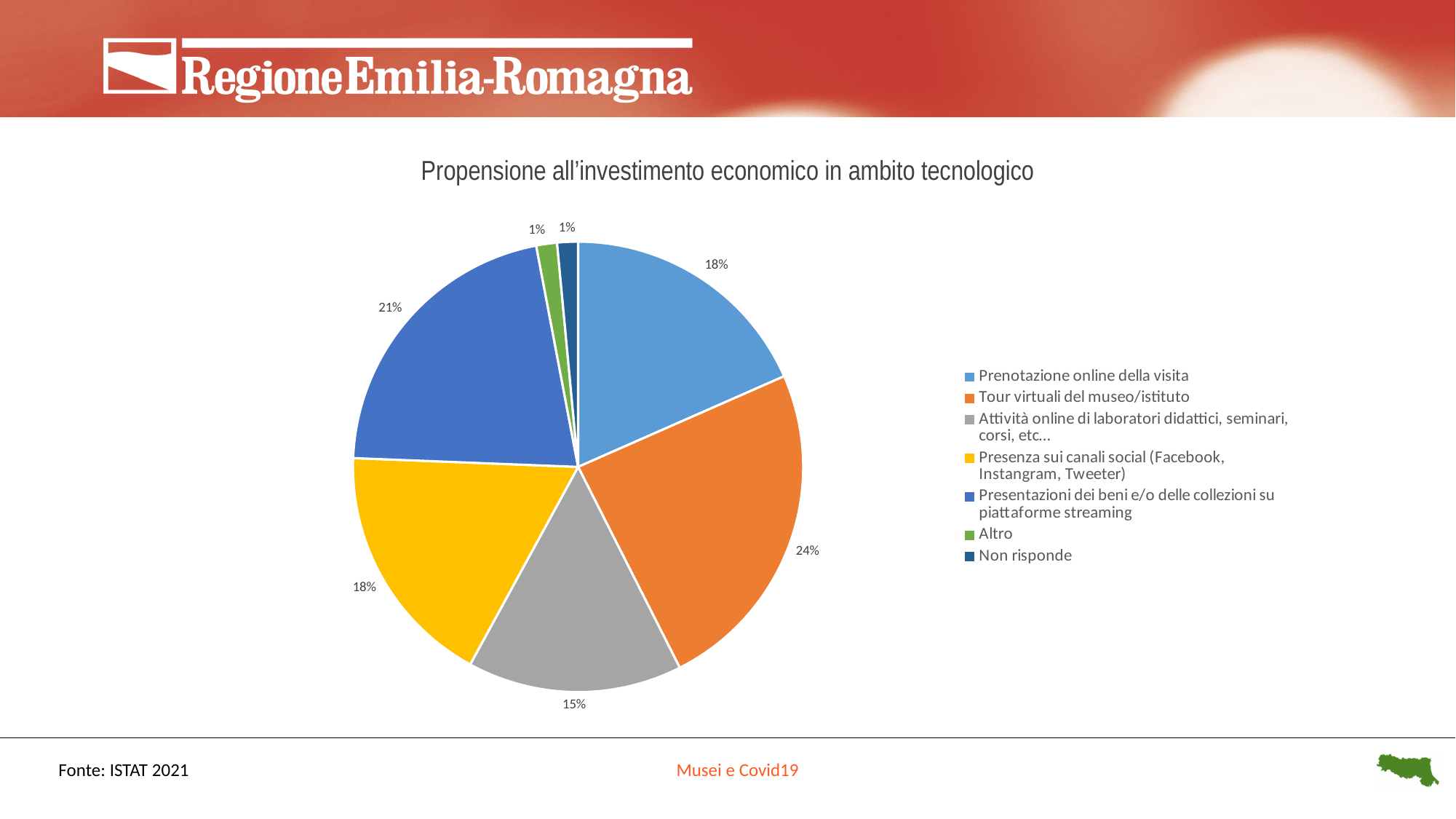
What colour is the slice for "Presenza sui canali social (Facebook, Instangram, Tweeter)"? Yellow What is the value shown for "Attività online di laboratori didattici, seminari, corsi, etc…"? 15% Which category has the largest slice of the pie? Tour virtuali del museo/istituto What is the value shown for "Altro"? 1% What type of chart is shown on the slide? Pie chart What is the difference in percentage points between "Tour virtuali del museo/istituto" and "Attività online di laboratori didattici, seminari, corsi, etc…"? 9 percentage points What is the value shown for "Prenotazione online della visita"? 18% What share of the pie does "Tour virtuali del museo/istituto" represent? 24% What is the value shown for "Presentazioni dei beni e/o delle collezioni su piattaforme streaming"? 21% What is the title of the chart? Propensione all'investimento economico in ambito tecnologico Which is larger: the slice for "Tour virtuali del museo/istituto" or the slice for "Presentazioni dei beni e/o delle collezioni su piattaforme streaming"? Tour virtuali del museo/istituto How many categories does the legend list? 7